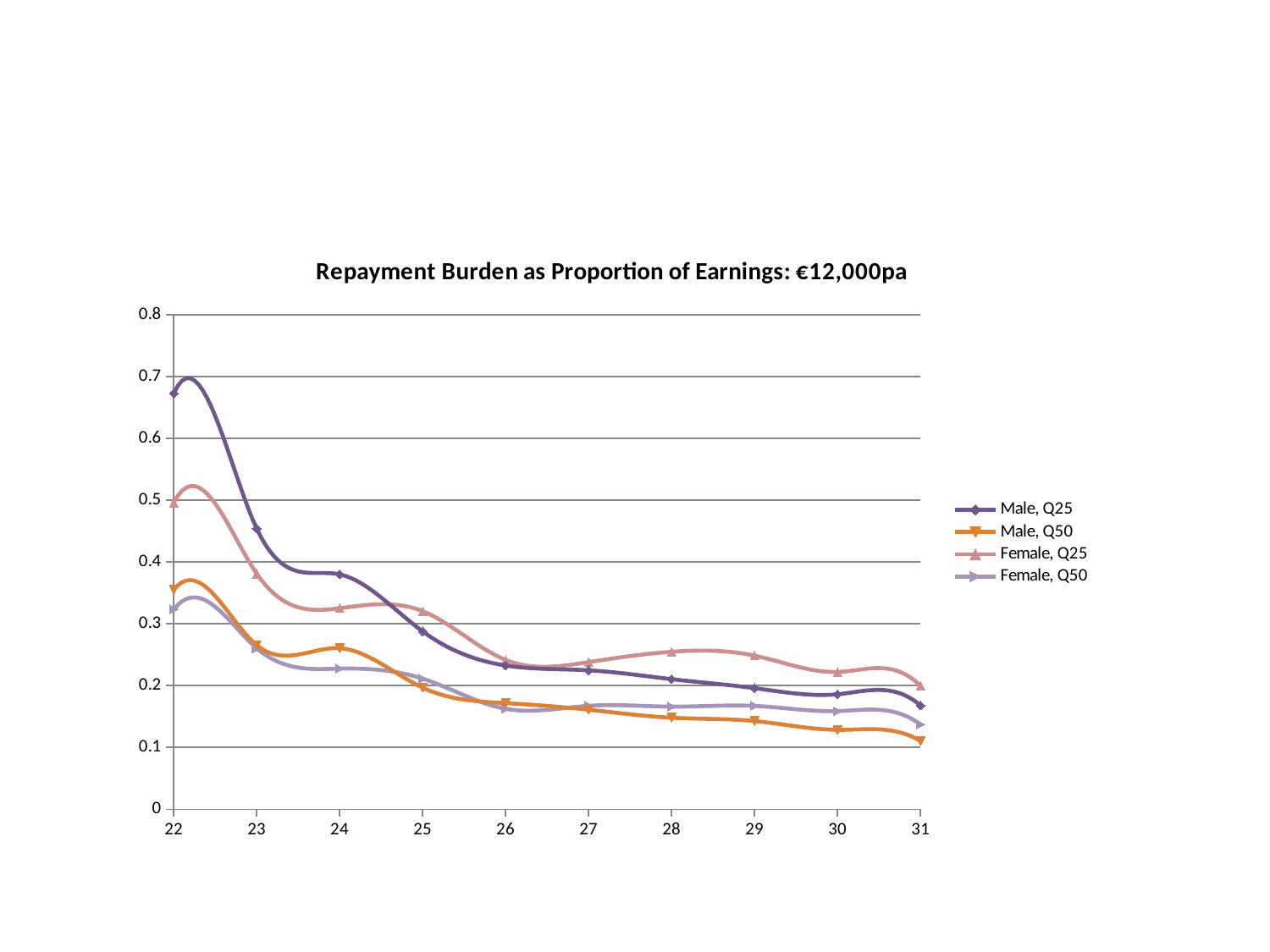
Which series is highest at age 22? Male, Q25 Is the value for Male, Q25 at age 22 greater or less than 0.6? greater What kind of chart is shown on the slide? Line chart At age 28, which is larger: Female, Q25 or Male, Q25? Female, Q25 What is the title of the chart? Repayment Burden as Proportion of Earnings: €12,000pa Does the Male, Q25 series rise or fall from age 22 to age 31? fall How many age points are plotted along the x axis? 10 How many series does the legend list? 4 Which series is highest at age 31? Female, Q25 Which series is lowest at age 31? Male, Q50 Is the value for Male, Q50 at age 31 greater or less than 0.2? less Is the value for Female, Q25 at age 22 greater or less than 0.4? greater